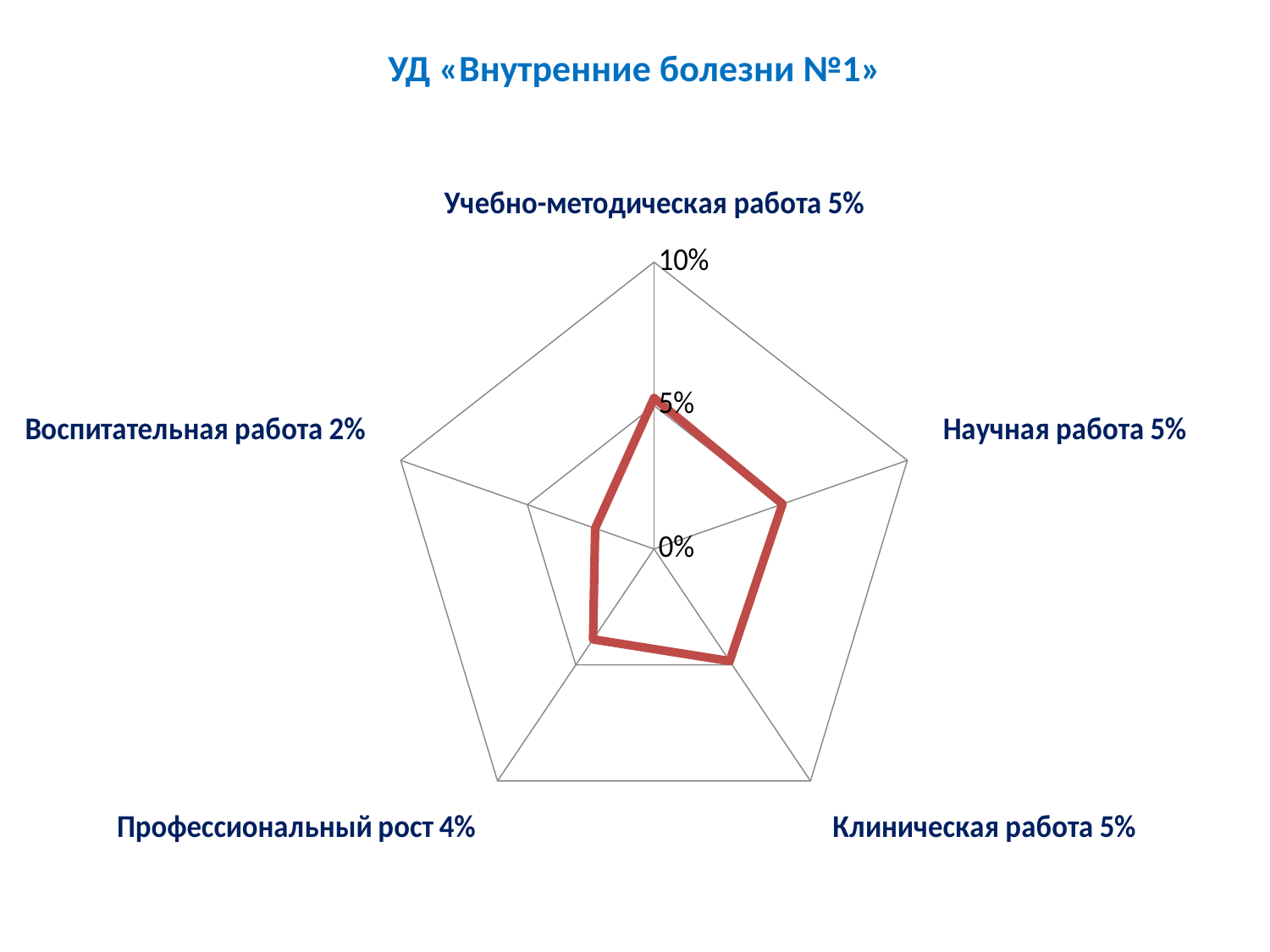
What is the value for Клиническая работа? 5% How many categories (axes) does the radar chart have? 5 Which category has the lowest value? Воспитательная работа What is the value for Профессиональный рост? 4% What is the value for Учебно-методическая работа? 5% What is the value for Научная работа? 5% What is the title of the chart? УД «Внутренние болезни №1» What kind of chart is shown on the slide? Radar chart What is the value for Воспитательная работа? 2% Which is larger, the value for Научная работа or the value for Воспитательная работа? Научная работа Is the value for Воспитательная работа greater or less than 5%? less